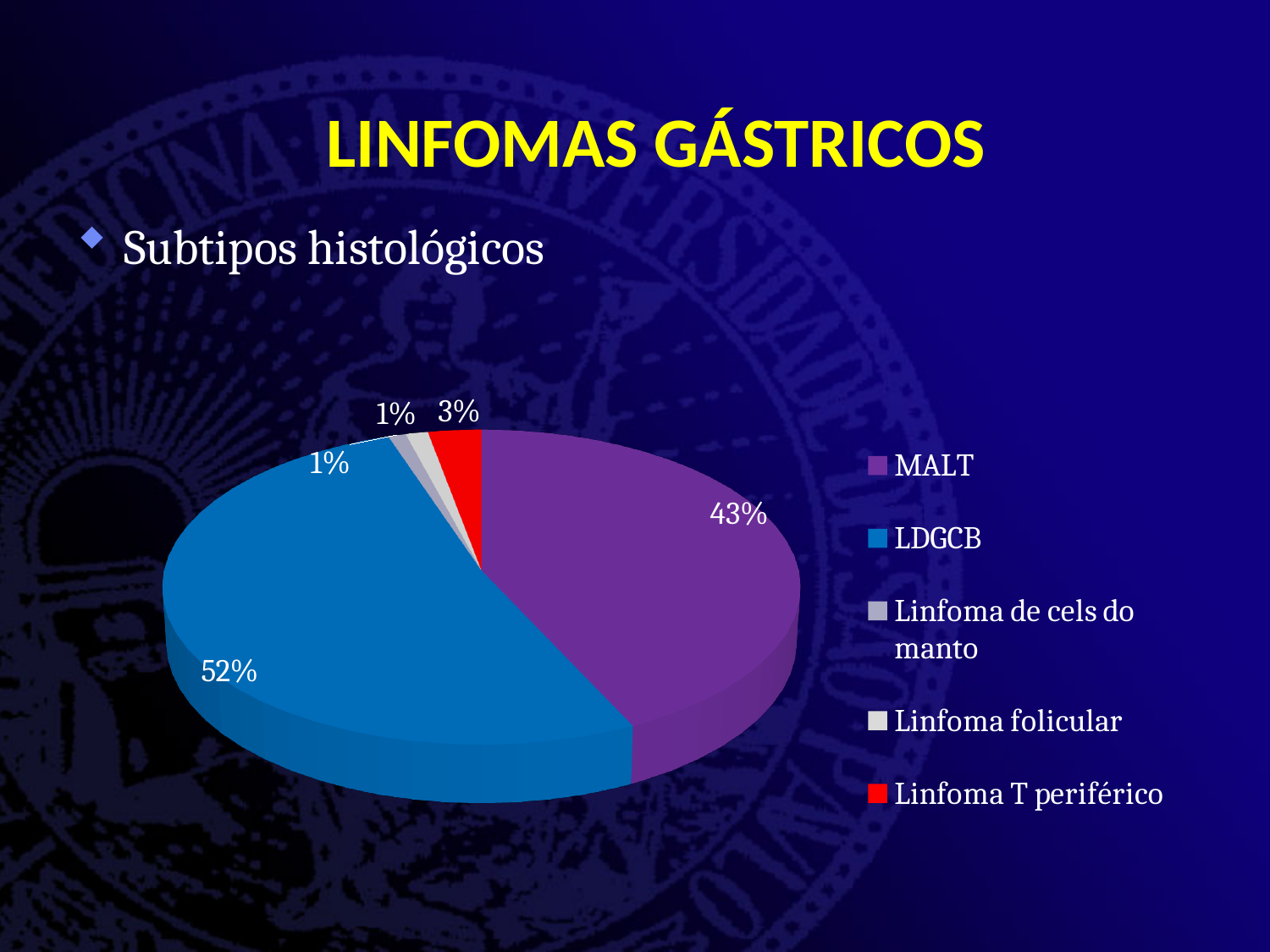
How many subtypes are listed in the legend of the pie chart? 5 What percentage is shown for Linfoma folicular? 1% What percentage is shown for Linfoma T periférico? 3% What colour is the slice for Linfoma T periférico? red What percentage of gastric lymphomas is LDGCB? 52% What is the combined share of MALT and LDGCB? 95% What percentage of gastric lymphomas is MALT? 43% Which is larger, the share for MALT or the share for Linfoma T periférico? MALT What kind of chart is shown on the slide? pie chart Which histological subtype has the largest share of the pie? LDGCB What percentage is shown for Linfoma de cels do manto? 1% What is the difference in percentage points between LDGCB and MALT? 9